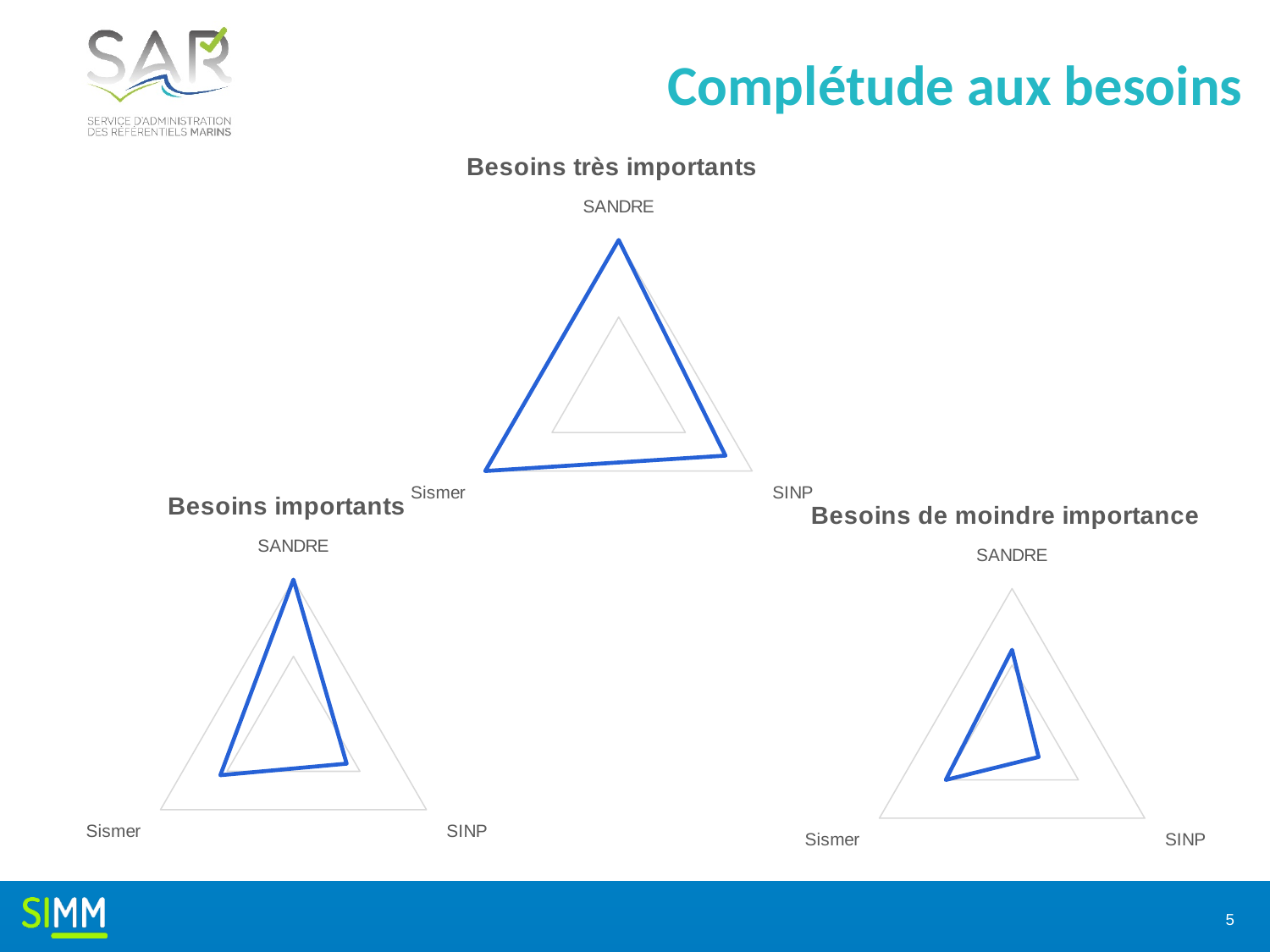
How many categories (axes) does the "Besoins importants" chart have? 3 In the "Besoins importants" chart, is the value for SANDRE larger or smaller than the value for Sismer? larger In the "Besoins de moindre importance" chart, which category has the lowest value? SINP What are the three axis labels on the "Besoins de moindre importance" chart? SANDRE, Sismer, SINP In the "Besoins de moindre importance" chart, which category has the highest value? SANDRE How many radar charts are shown on the slide? 3 What is the title of the chart at the top centre of the slide? Besoins très importants How many data series are plotted in the "Besoins importants" chart? 1 In the "Besoins très importants" chart, which category has the lowest value? SINP In the "Besoins importants" chart, which category has the highest value? SANDRE In the "Besoins de moindre importance" chart, is the value for SANDRE larger or smaller than the value for SINP? larger What kind of chart is "Besoins très importants"? Radar chart